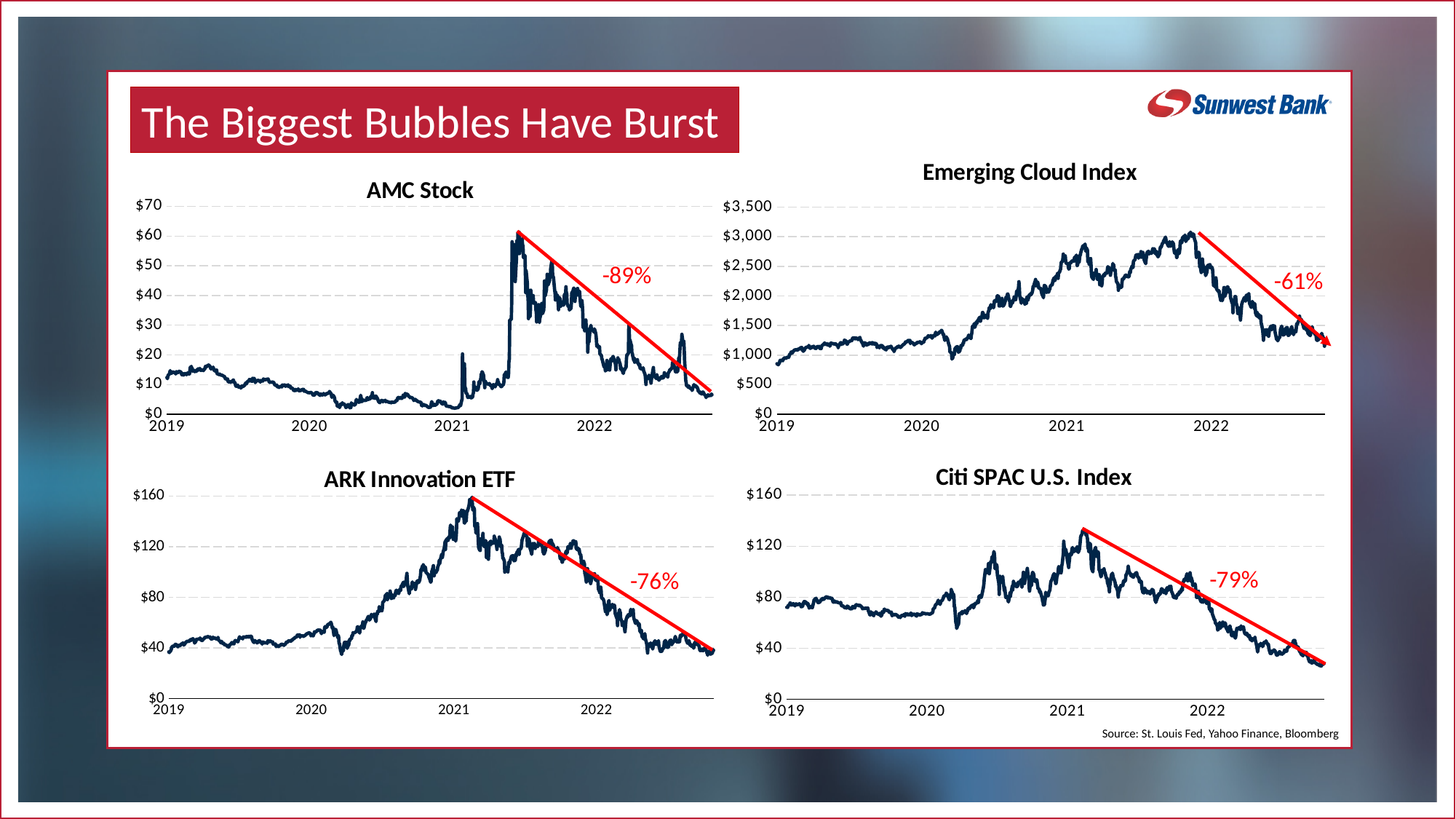
On the AMC Stock chart, what percentage decline is annotated in red? -89% How many charts are shown on the slide? 4 Across the four charts, which one shows the smallest annotated percentage decline? Emerging Cloud Index Which has the larger annotated decline, the ARK Innovation ETF chart or the Citi SPAC U.S. Index chart? Citi SPAC U.S. Index On the Emerging Cloud Index chart, what percentage decline is annotated in red? -61% What kind of chart is the AMC Stock chart? Line chart On the ARK Innovation ETF chart, do the values rise or fall from the early 2021 peak to the end of 2022? fall On the ARK Innovation ETF chart, what percentage decline is annotated in red? -76% What is the difference in percentage points between the annotated decline on the AMC Stock chart and the one on the Emerging Cloud Index chart? 28 percentage points On the Emerging Cloud Index chart, is the peak value reached in late 2021 greater or less than $2,500? greater Across the four charts, which one shows the largest annotated percentage decline? AMC Stock On the Citi SPAC U.S. Index chart, what percentage decline is annotated in red? -79%